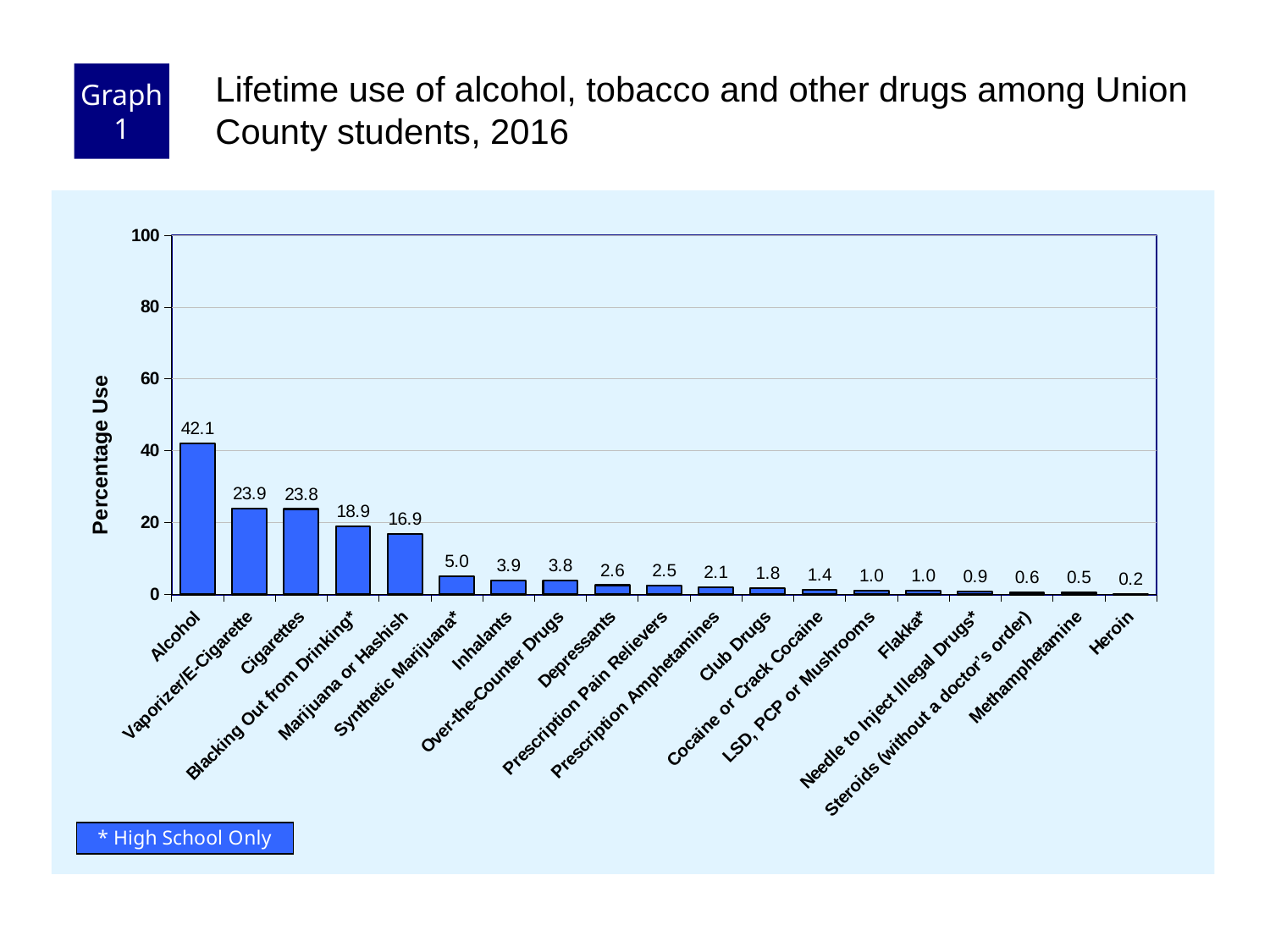
What is the difference in percentage use between Alcohol and Cigarettes? 18.3 What is the percentage use for Marijuana or Hashish? 16.9 Which has a higher percentage use, Club Drugs or Depressants? Depressants What is the percentage use for Alcohol? 42.1 What is the percentage use for Inhalants? 3.9 Which category has the lowest percentage use? Heroin Which category has the highest percentage use? Alcohol What kind of chart is shown on the slide? Bar chart What is the difference in percentage use between Blacking Out from Drinking* and Synthetic Marijuana*? 13.9 Is the value for Vaporizer/E-Cigarette greater or less than 20? greater How many categories are shown on the chart? 19 What is the percentage use for Methamphetamine? 0.5